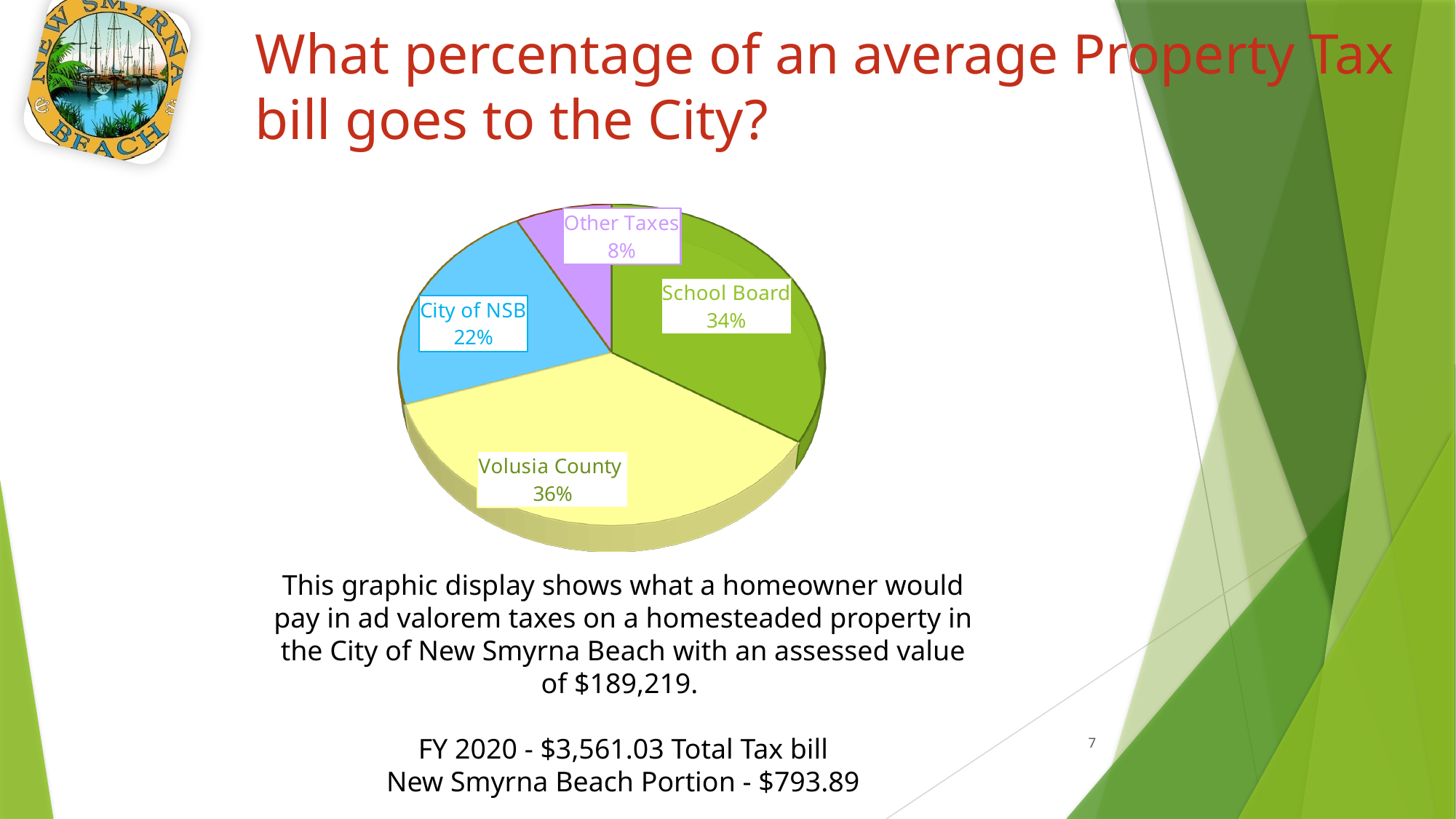
What percentage does Volusia County take in the pie chart? 36% What is the combined percentage of the School Board and Volusia County slices? 70% Which slice of the pie chart is the smallest? Other Taxes How many slices does the pie chart have? 4 Which slice of the pie chart is the largest? Volusia County Which is larger in the pie chart, School Board or City of NSB? School Board What is the difference in percentage points between the Volusia County and City of NSB slices? 14 What kind of chart is shown on the slide? Pie chart What percentage is shown for Other Taxes in the pie chart? 8% What colour is the City of NSB slice in the pie chart? Blue What percentage of the pie chart goes to the City of NSB? 22% What share of the pie chart is labelled School Board? 34%